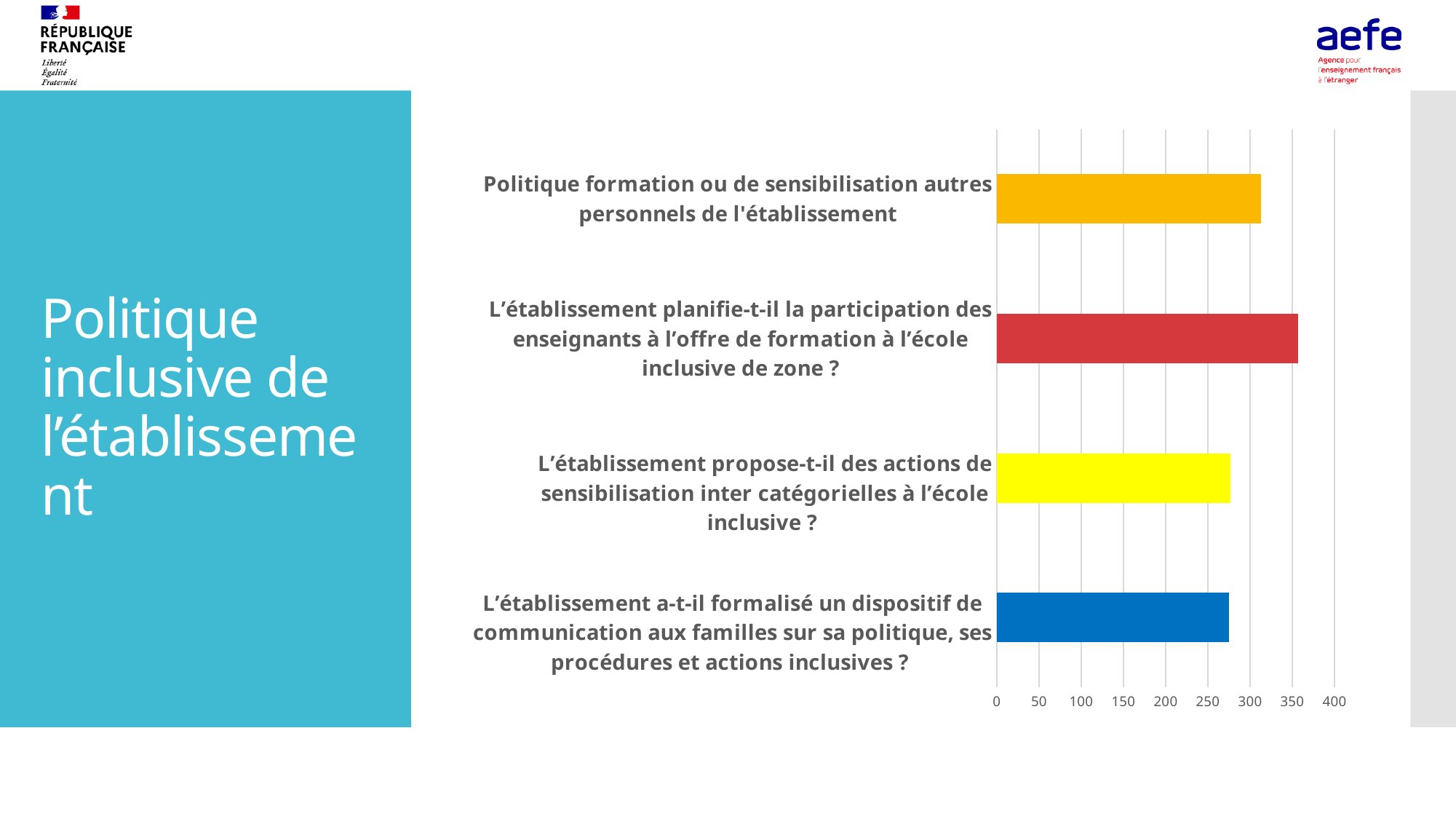
Is the value for "L’établissement propose-t-il des actions de sensibilisation inter catégorielles à l’école inclusive ?" greater or less than 300? less Which category has the highest value in the bar chart? L’établissement planifie-t-il la participation des enseignants à l’offre de formation à l’école inclusive de zone ? What kind of chart is shown on the slide? bar chart Is the value for "L’établissement a-t-il formalisé un dispositif de communication aux familles sur sa politique, ses procédures et actions inclusives ?" greater or less than 250? greater Which is larger: the value for "Politique formation ou de sensibilisation autres personnels de l'établissement" or the value for "L’établissement propose-t-il des actions de sensibilisation inter catégorielles à l’école inclusive ?"? Politique formation ou de sensibilisation autres personnels de l'établissement What colour is the bar for "L’établissement planifie-t-il la participation des enseignants à l’offre de formation à l’école inclusive de zone ?"? red Is the value for "Politique formation ou de sensibilisation autres personnels de l'établissement" greater or less than 300? greater How many categories (questions) are plotted in the bar chart? 4 What is the maximum value shown on the horizontal axis of the chart? 400 Which is larger: the value for "L’établissement planifie-t-il la participation des enseignants à l’offre de formation à l’école inclusive de zone ?" or the value for "Politique formation ou de sensibilisation autres personnels de l'établissement"? L’établissement planifie-t-il la participation des enseignants à l’offre de formation à l’école inclusive de zone ?